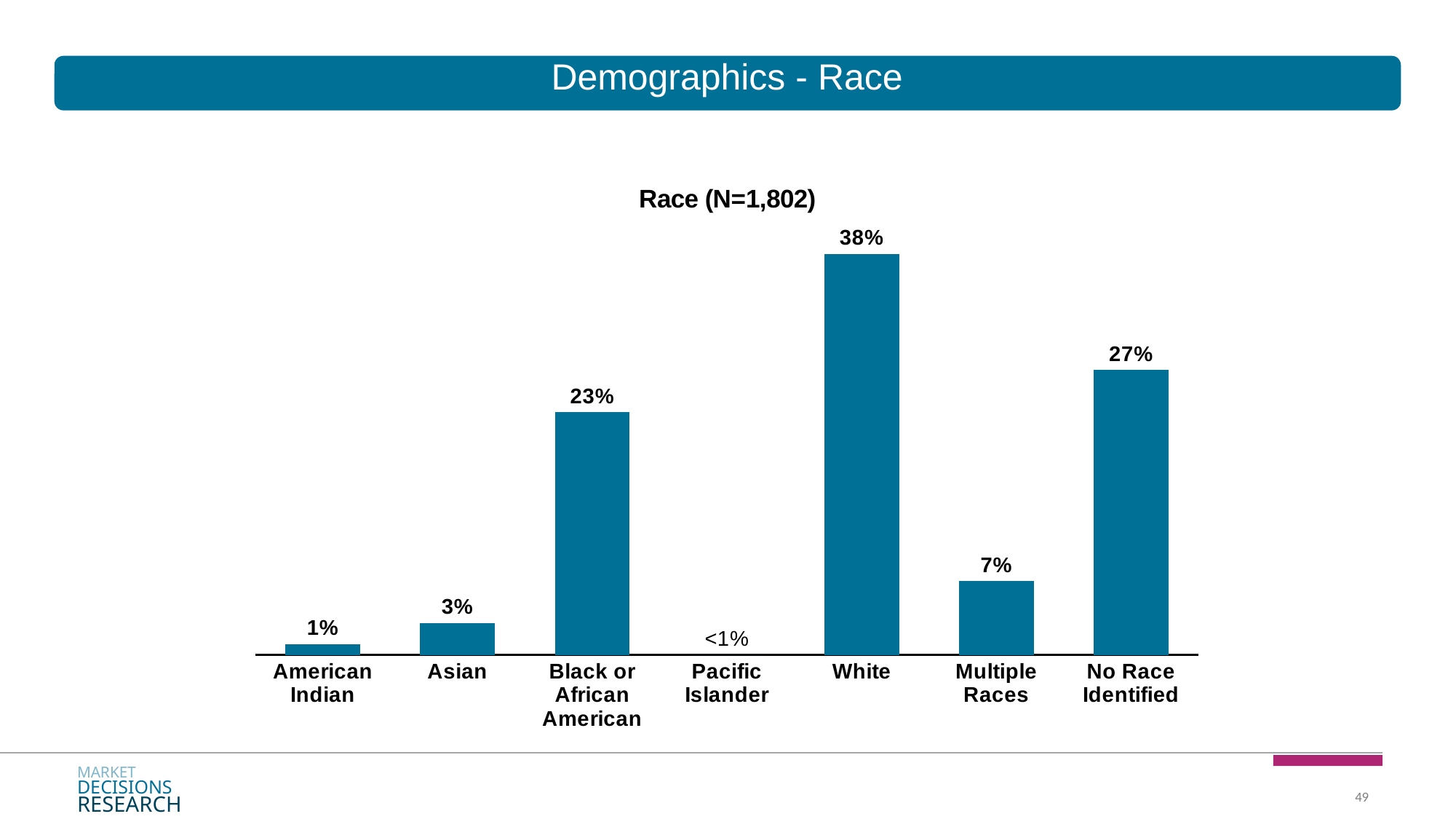
Which race category has the highest percentage? White Which is larger, the percentage for Black or African American or the percentage for No Race Identified? No Race Identified What value is shown for Pacific Islander? <1% How many race categories are shown on the x axis? 7 What is the sample size (N) given in the chart title? 1,802 What is the difference between the percentages for White and No Race Identified? 11% What is the value shown for Black or African American? 23% What percentage is shown for No Race Identified? 27% What percentage of respondents identified as White? 38% What type of chart is shown on the slide? Bar chart Which race category has the lowest percentage? Pacific Islander What is the difference between the percentages for Multiple Races and Asian? 4%